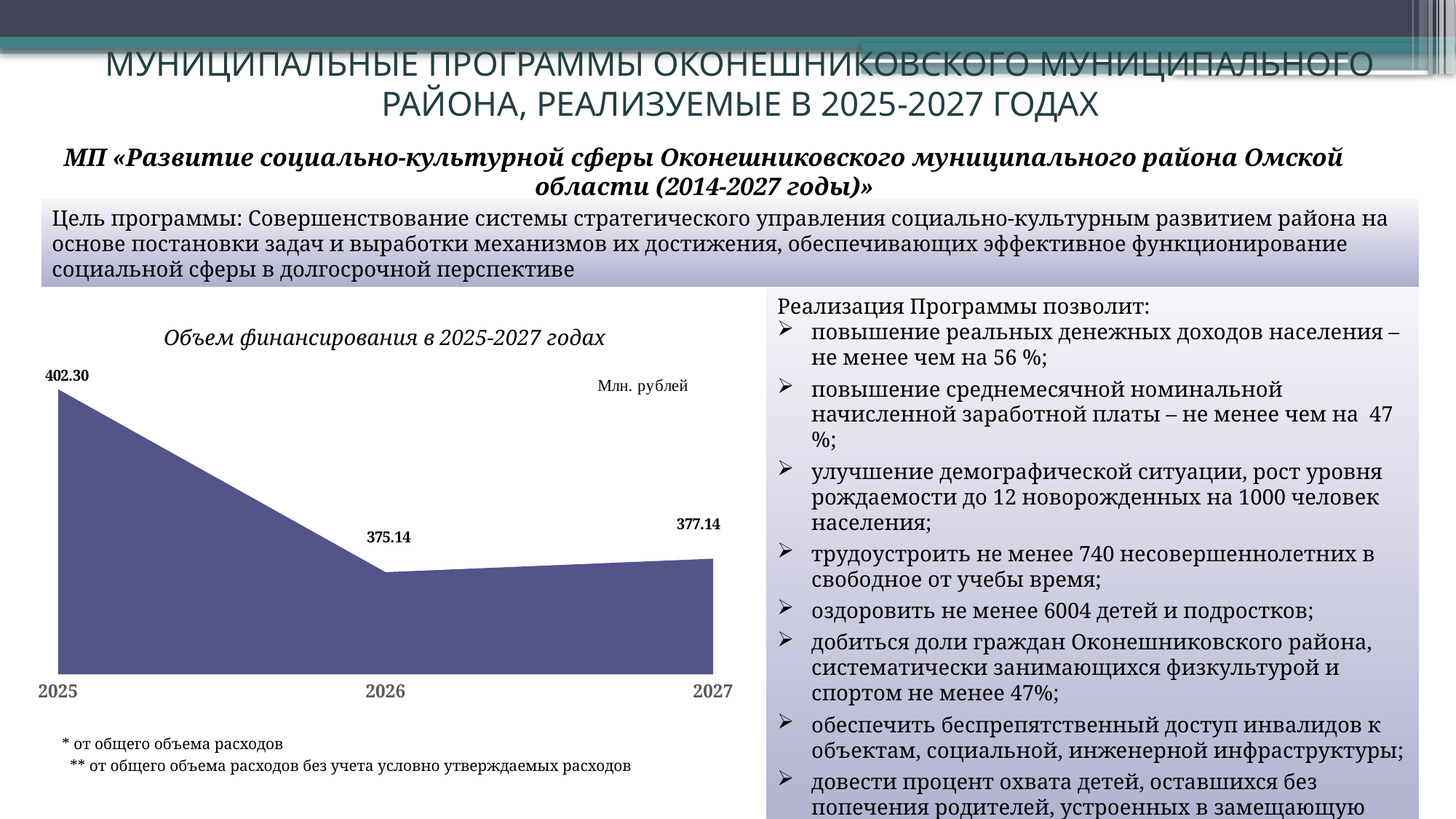
What is the value for 2025 in the chart 'Объем финансирования в 2025-2027 годах'? 402.30 What is the value for 2027 in the chart 'Объем финансирования в 2025-2027 годах'? 377.14 How many years are plotted in the chart 'Объем финансирования в 2025-2027 годах'? 3 What is the difference between the values for 2027 and 2026 in the chart 'Объем финансирования в 2025-2027 годах'? 2.00 What is the value for 2026 in the chart 'Объем финансирования в 2025-2027 годах'? 375.14 Which year has the highest value in the chart 'Объем финансирования в 2025-2027 годах'? 2025 What is the difference between the values for 2025 and 2026 in the chart 'Объем финансирования в 2025-2027 годах'? 27.16 Does the value in the chart 'Объем финансирования в 2025-2027 годах' rise or fall from 2025 to 2026? fall Which year has the lowest value in the chart 'Объем финансирования в 2025-2027 годах'? 2026 In the chart 'Объем финансирования в 2025-2027 годах', is the value for 2025 larger or smaller than the value for 2027? larger What kind of chart is 'Объем финансирования в 2025-2027 годах'? area chart What unit is shown on the chart 'Объем финансирования в 2025-2027 годах'? Млн. рублей